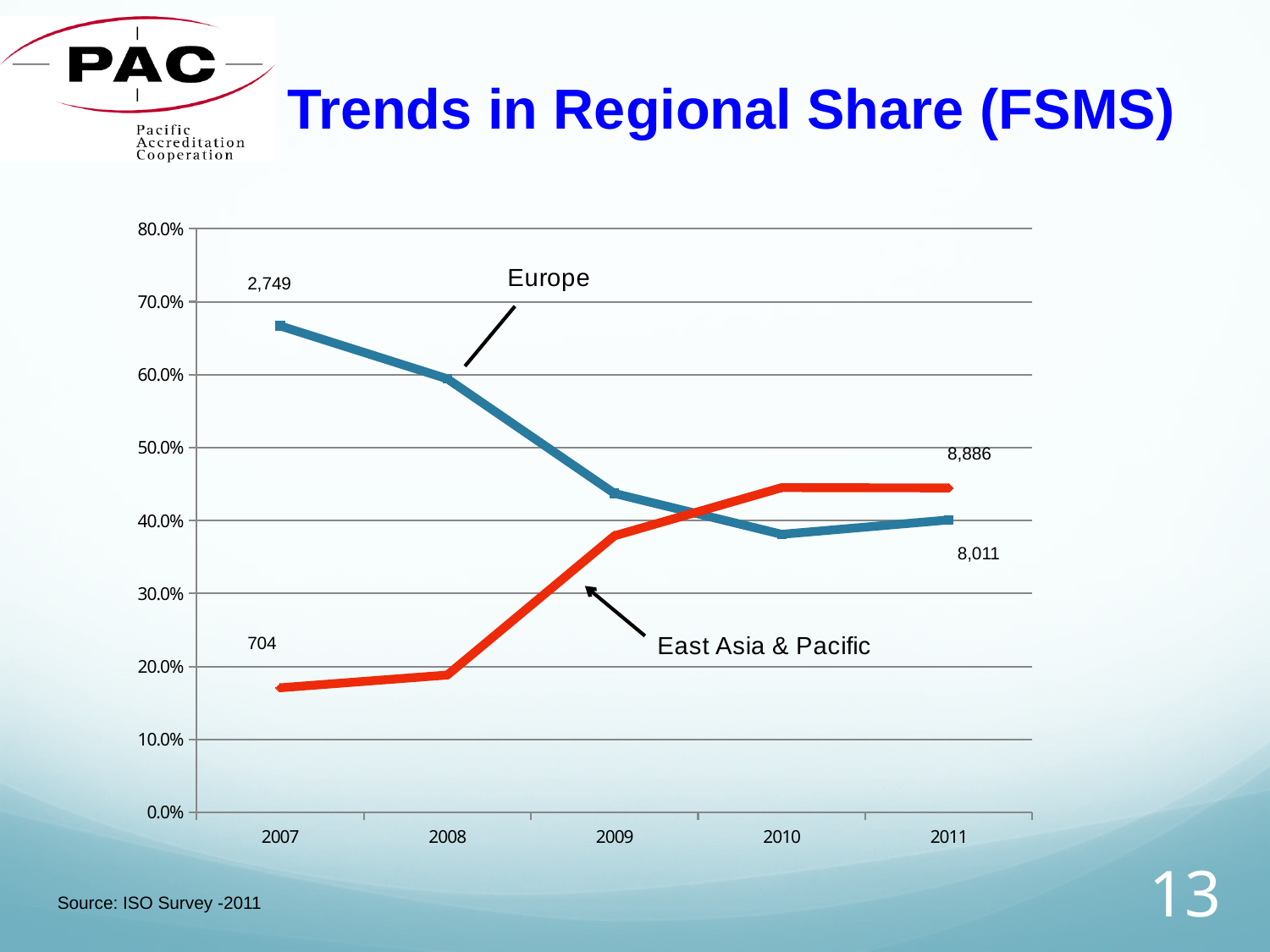
In 2007, which region has the larger share, Europe or East Asia & Pacific? Europe In 2011, which region has the larger share, Europe or East Asia & Pacific? East Asia & Pacific Which two regions are labelled on the chart? Europe and East Asia & Pacific How many years are plotted along the x axis? 5 Does the share for East Asia & Pacific rise or fall from 2007 to 2011? rise What kind of chart is shown on the slide? line chart Is the value for Europe in 2007 greater or less than 60.0%? greater How many series are plotted on the chart? 2 Is the value for East Asia & Pacific in 2007 greater or less than 20.0%? less Is the value for East Asia & Pacific in 2010 greater or less than 40.0%? greater Does the share for Europe rise or fall from 2007 to 2011? fall